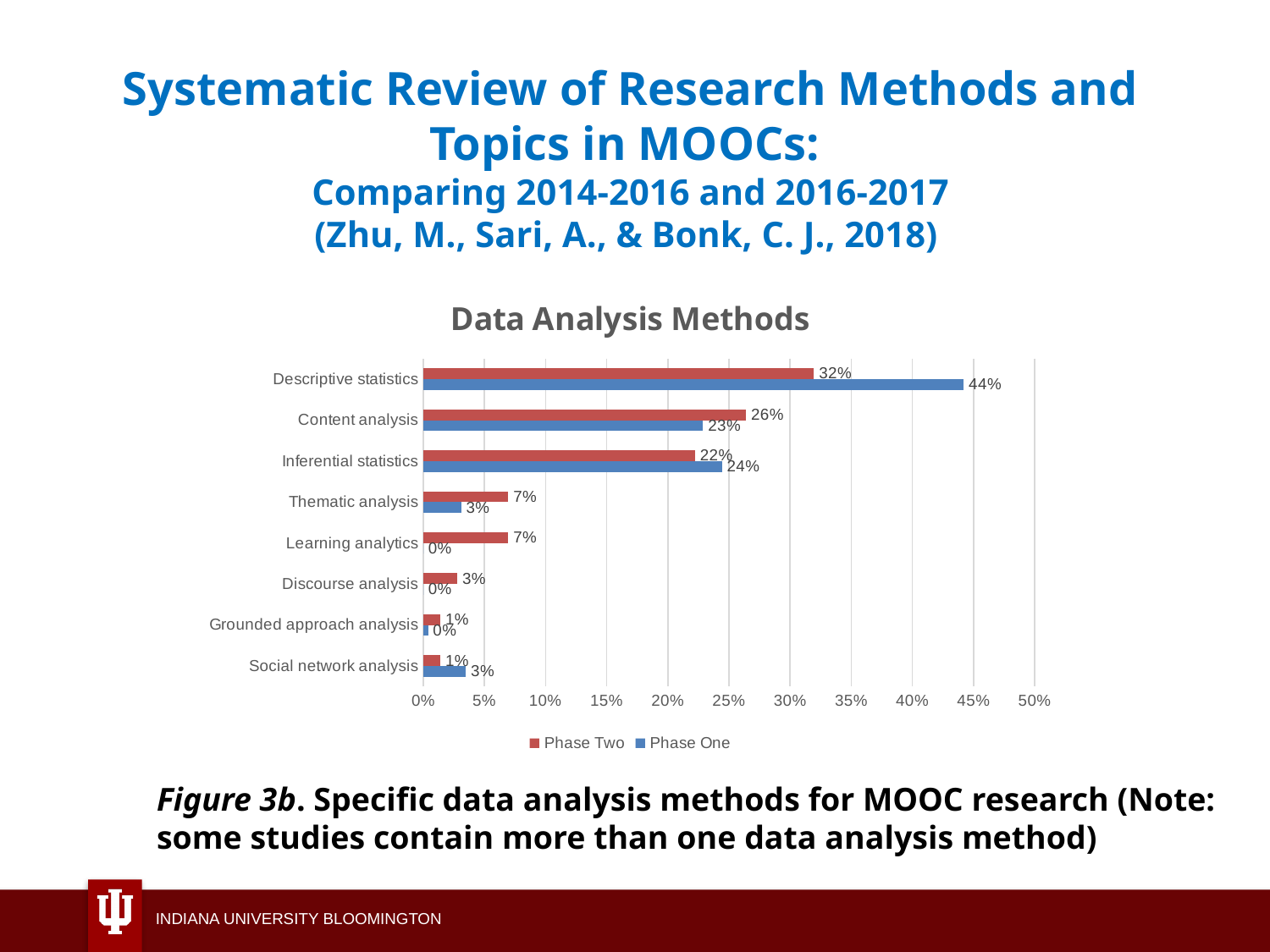
What is the Phase One value for Inferential statistics? 24% What is the Phase Two value for Content analysis? 26% What is the Phase One value for Descriptive statistics? 44% Which data analysis method has the highest Phase Two value? Descriptive statistics Which data analysis method has the highest Phase One value? Descriptive statistics How many data analysis methods are listed on the chart? 8 What kind of chart is shown? Bar chart What is the difference between the Phase One and Phase Two values for Descriptive statistics? 12% How many series does the legend list? 2 What is the Phase Two value for Learning analytics? 7% What is the title of the chart? Data Analysis Methods Which is larger for Content analysis, the Phase One value or the Phase Two value? Phase Two